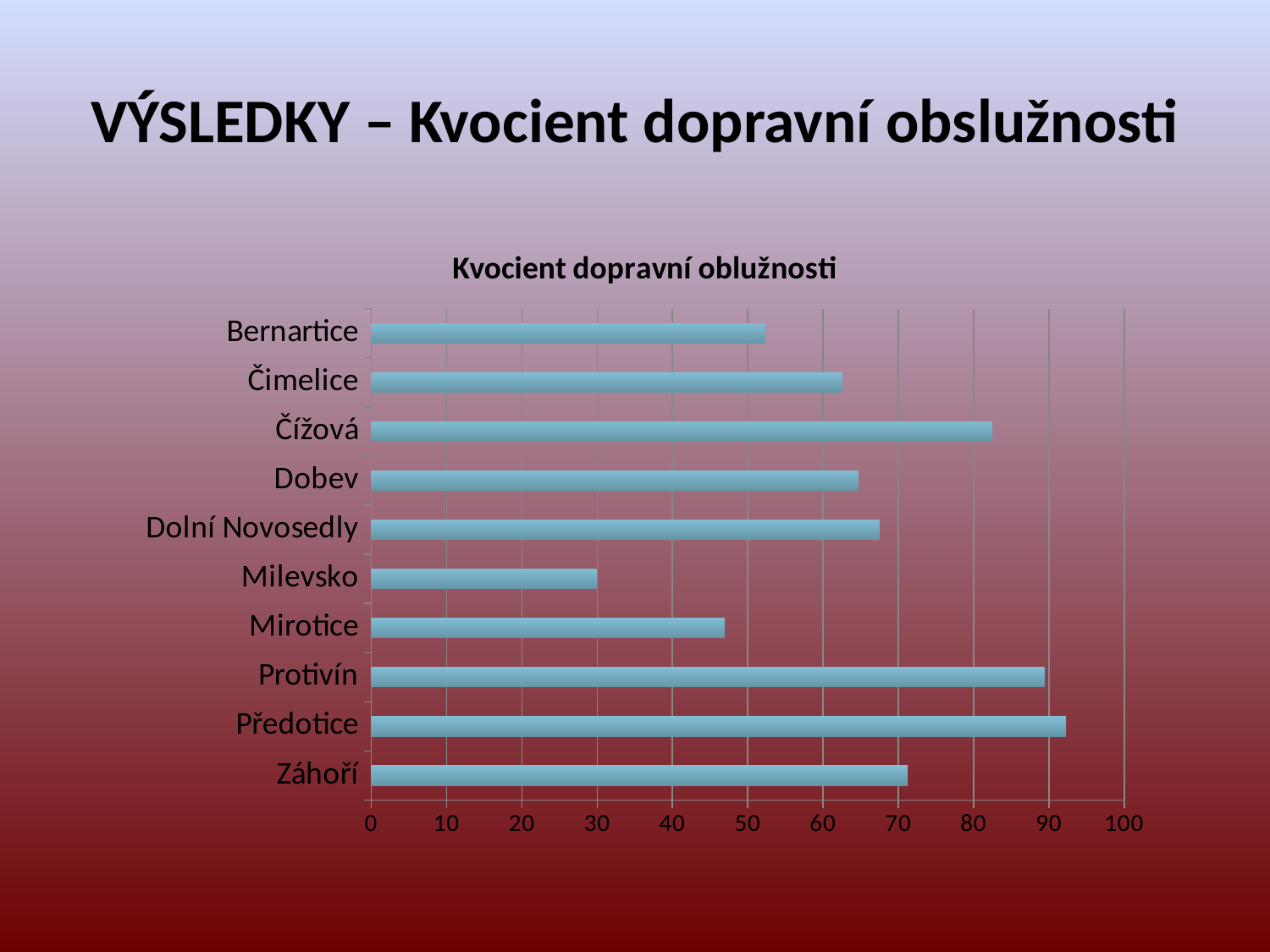
Which municipality has the lowest value in the chart? Milevsko What kind of chart is shown on the slide? bar chart Is the value for Bernartice greater or less than 50? greater How many municipalities are plotted in the chart? 10 What is the title of the chart? Kvocient dopravní oblužnosti Which has the larger value, Milevsko or Mirotice? Mirotice Is the value for Mirotice greater or less than 50? less Which municipality has the highest value in the chart? Předotice Which has the larger value, Čížová or Dobev? Čížová Is the value for Čížová greater or less than 80? greater